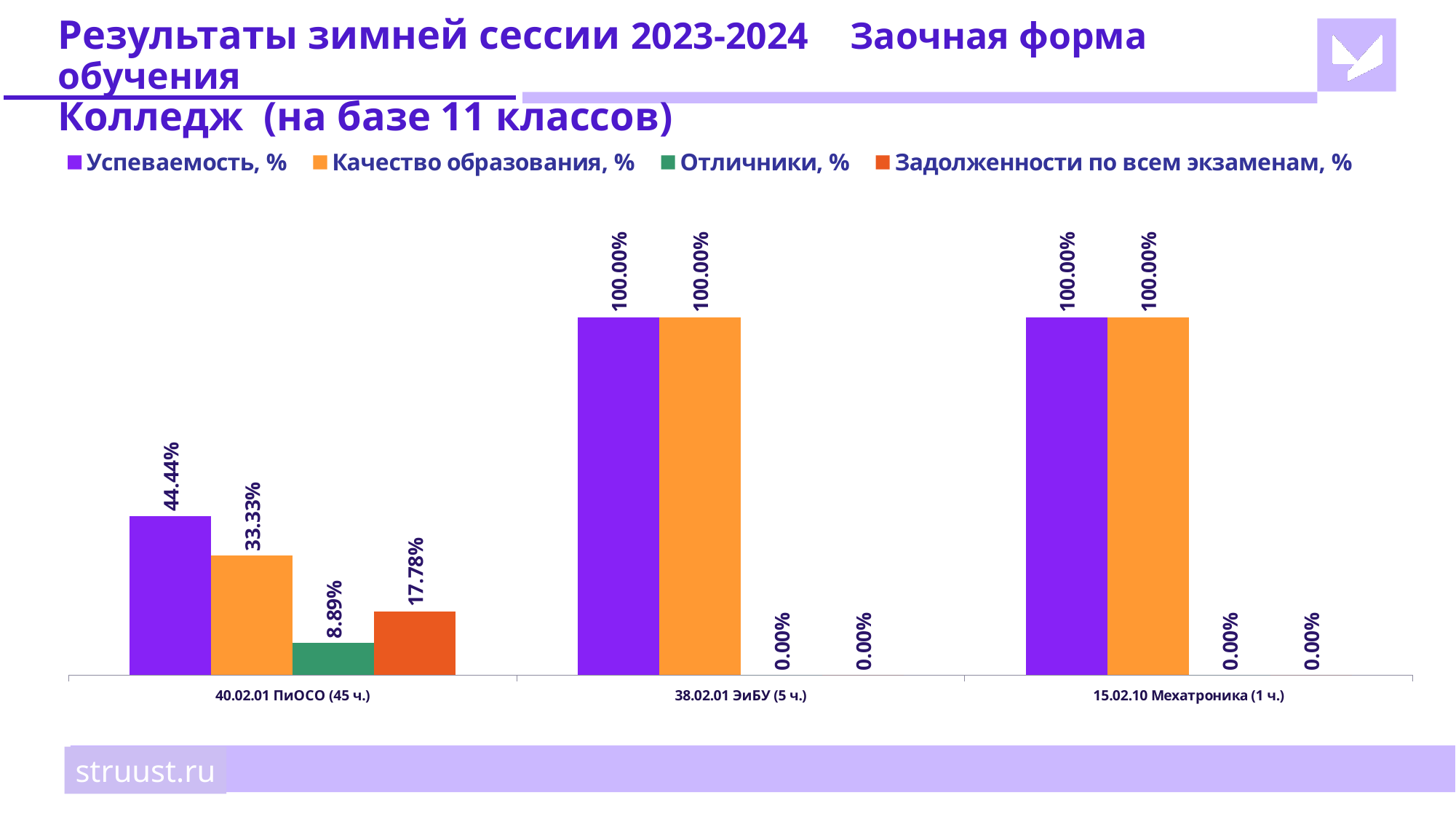
What is the value of Успеваемость, % for 40.02.01 ПиОСО (45 ч.)? 44.44% What is the value of Задолженности по всем экзаменам, % for 40.02.01 ПиОСО (45 ч.)? 17.78% How many categories are shown on the x axis? 3 How many series does the legend list? 4 What kind of chart is shown on the slide? bar chart What is the difference between Успеваемость, % and Качество образования, % for 40.02.01 ПиОСО (45 ч.)? 11.11% What is the value of Отличники, % for 40.02.01 ПиОСО (45 ч.)? 8.89% What is the value of Отличники, % for 15.02.10 Мехатроника (1 ч.)? 0.00% Which category has the lowest value for Успеваемость, %? 40.02.01 ПиОСО (45 ч.) For 40.02.01 ПиОСО (45 ч.), which is larger: Задолженности по всем экзаменам, % or Отличники, %? Задолженности по всем экзаменам, % What is the value of Качество образования, % for 40.02.01 ПиОСО (45 ч.)? 33.33% What is the value of Успеваемость, % for 38.02.01 ЭиБУ (5 ч.)? 100.00%